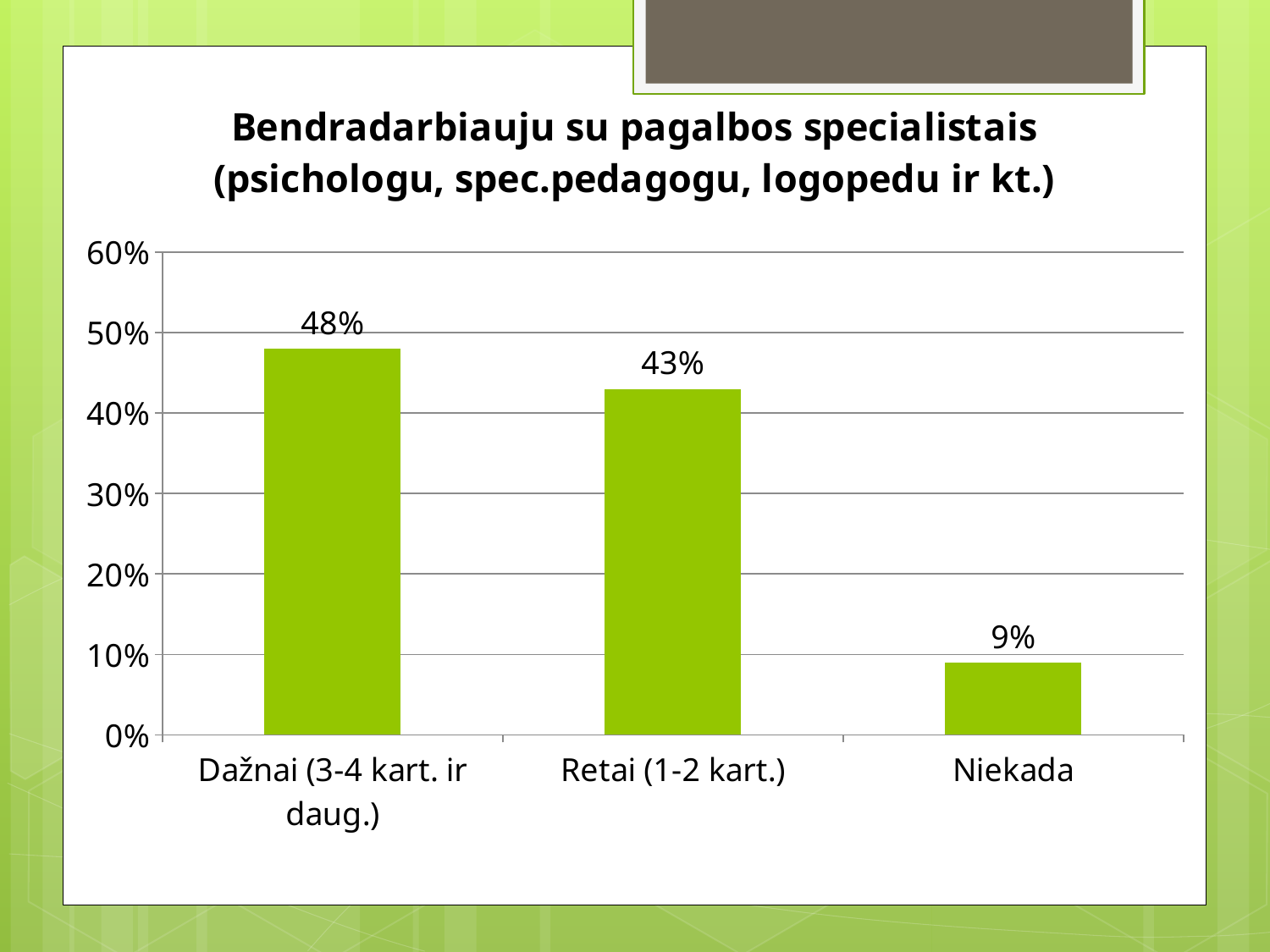
Which category has the lowest value? Niekada What is the value for "Retai (1-2 kart.)"? 43% How many categories are shown on the x axis? 3 What kind of chart is shown on the slide? bar chart What is the value for "Dažnai (3-4 kart. ir daug.)"? 48% What is the value for "Niekada"? 9% What is the difference between the values for "Dažnai (3-4 kart. ir daug.)" and "Retai (1-2 kart.)"? 5% What is the difference between the values for "Retai (1-2 kart.)" and "Niekada"? 34% Which category has the highest value? Dažnai (3-4 kart. ir daug.) Which is larger, the value for "Retai (1-2 kart.)" or the value for "Niekada"? Retai (1-2 kart.) Is the value for "Niekada" greater or less than 10%? less Do the values rise or fall from left to right along the x axis? fall